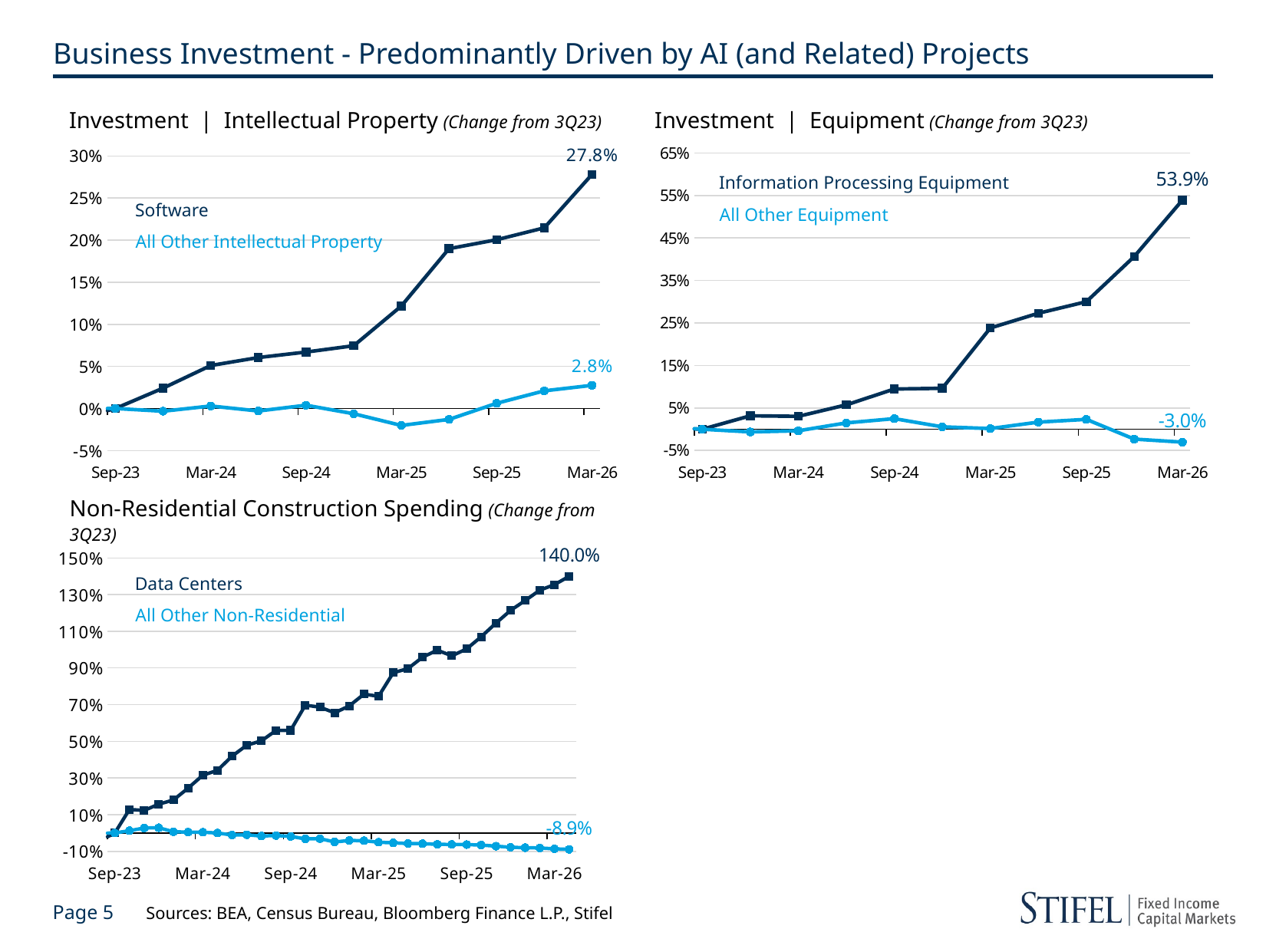
In the Investment | Equipment chart, what is the final value shown for Information Processing Equipment? 53.9% In the Investment | Intellectual Property chart, what is the difference between the final Software value and the final All Other Intellectual Property value? 25.0 percentage points In the Non-Residential Construction Spending chart, what is the final value shown for Data Centers? 140.0% How many series does the Investment | Equipment chart show? 2 In the Non-Residential Construction Spending chart, does the All Other Non-Residential line generally rise or fall from Sep-23 to Mar-26? fall What type of chart is the Non-Residential Construction Spending chart? line chart In the Investment | Equipment chart, what is the final value shown for All Other Equipment? -3.0% In the Investment | Intellectual Property chart, is the value for Software at Mar-25 greater or less than 10%? greater In the Investment | Equipment chart, which series ends higher at Mar-26, Information Processing Equipment or All Other Equipment? Information Processing Equipment In the Investment | Intellectual Property chart, what is the final value shown for Software at Mar-26? 27.8% In the Investment | Intellectual Property chart, what is the final value shown for All Other Intellectual Property? 2.8% In the Non-Residential Construction Spending chart, what is the final value shown for All Other Non-Residential? -8.9%